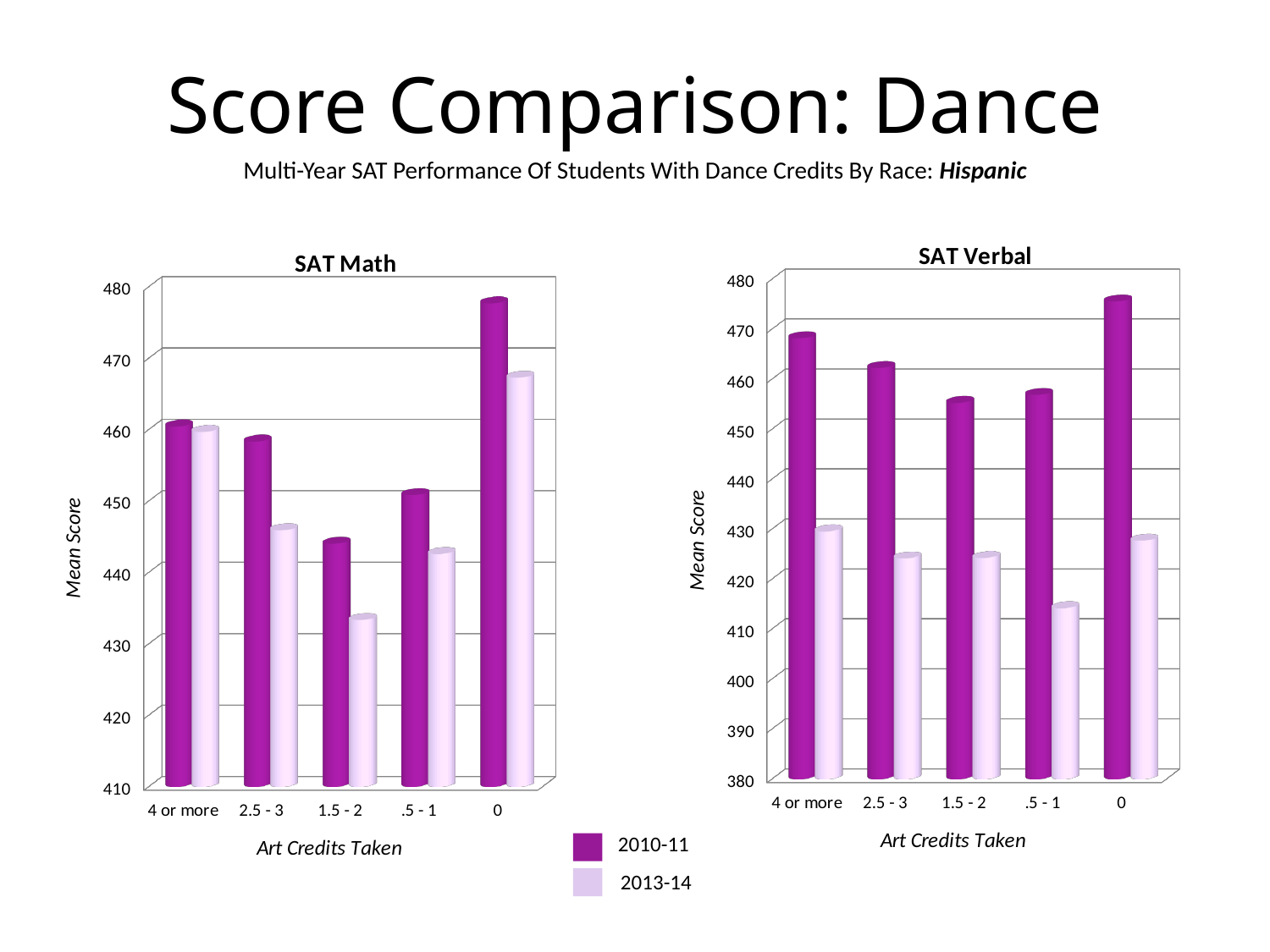
What is the x-axis title of the SAT Math chart? Art Credits Taken In the SAT Math chart, is the 2013-14 value for 1.5 - 2 credits greater or less than 440? less How many categories are shown on the x axis of the SAT Verbal chart? 5 In the SAT Verbal chart, which Art Credits Taken category has the highest 2010-11 mean score? 0 What kind of chart is the SAT Math chart? bar chart In the SAT Math chart, which Art Credits Taken category has the highest 2010-11 mean score? 0 In the SAT Math chart, is the 2010-11 value for 0 credits greater or less than 470? greater How many series does the legend list for the charts? 2 In the SAT Verbal chart, which Art Credits Taken category has the lowest 2013-14 mean score? .5 - 1 In the SAT Math chart, which Art Credits Taken category has the lowest 2013-14 mean score? 1.5 - 2 In the SAT Verbal chart, is the 2013-14 value for 4 or more credits greater or less than 420? greater In the SAT Verbal chart, which is larger for 2010-11: the value for 4 or more credits or the value for 2.5 - 3 credits? 4 or more